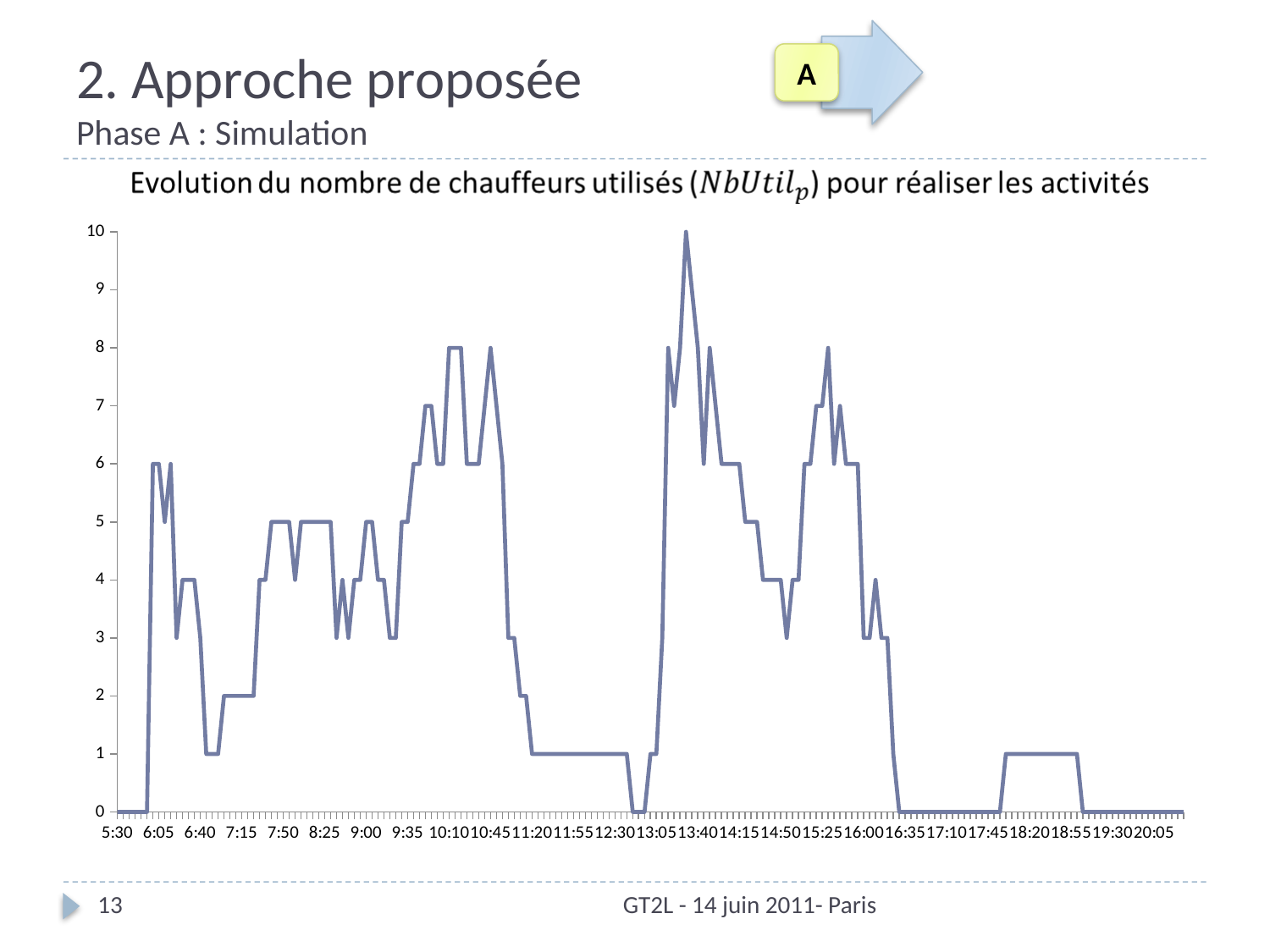
Is the value at 10:10 greater or less than 5? greater What is the value of the line at 20:05? 0 Is the value at 17:10 greater or less than 2? less What is the lowest value reached by the line? 0 Between 16:00 and 16:35, does the line rise or fall? fall What is the title of the chart? Evolution du nombre de chauffeurs utilisés (NbUtil_p) pour réaliser les activités What is the value of the line at 5:30? 0 Which is larger, the value at 10:10 or the value at 11:55? 10:10 What is the highest value reached by the line? 10 Is the value at 11:55 greater or less than 3? less What kind of chart is shown on the slide? line chart How many lines are plotted on the chart? 1